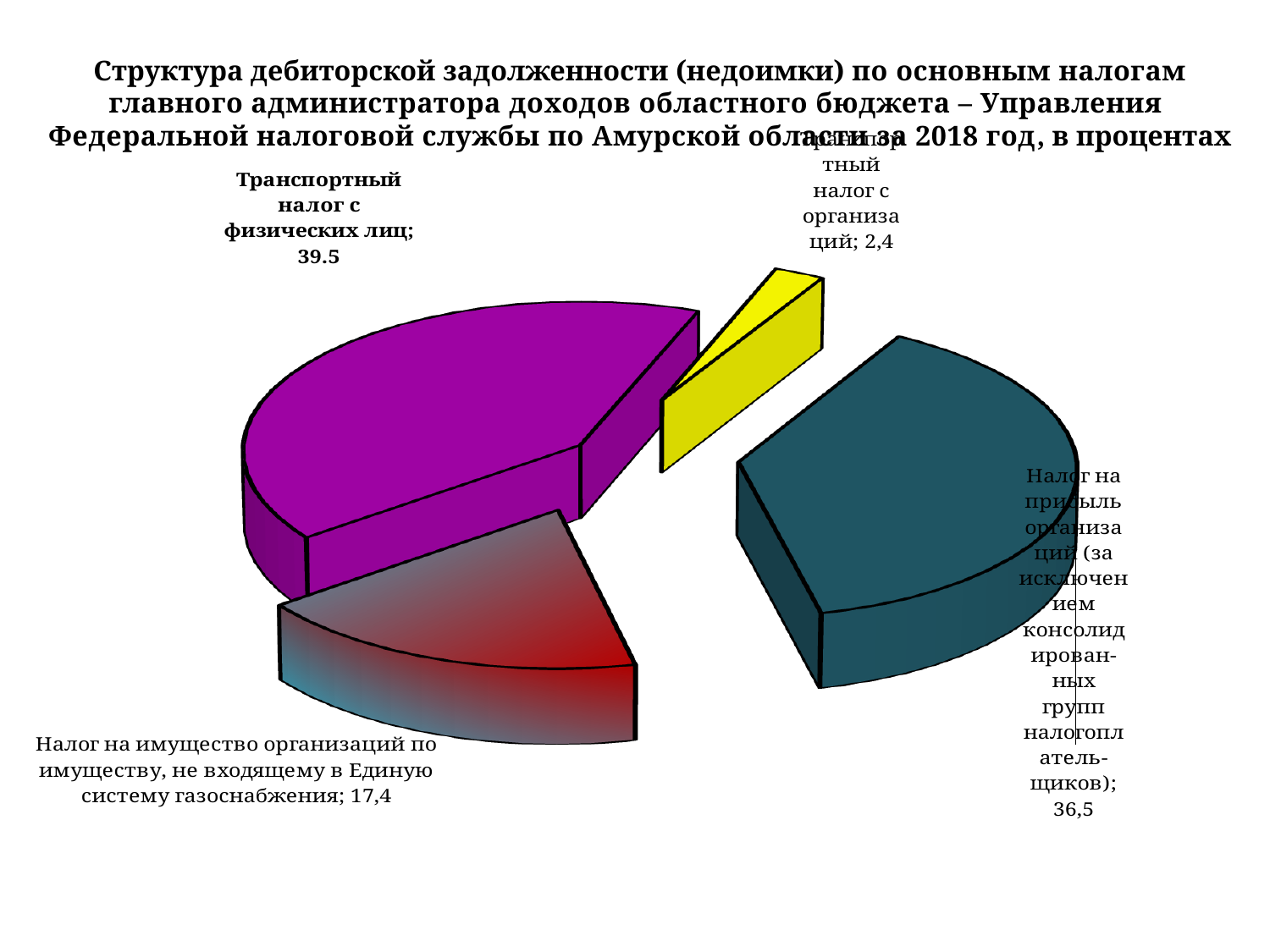
What is the value shown for the slice "Налог на прибыль организаций (за исключением консолидированных групп налогоплательщиков)"? 36,5 What kind of chart is shown on the slide? Pie chart What is the value shown for the slice "Транспортный налог с организаций"? 2,4 What is the value shown for the slice "Налог на имущество организаций по имуществу, не входящему в Единую систему газоснабжения"? 17,4 What is the difference between the values for "Транспортный налог с физических лиц" and "Налог на имущество организаций по имуществу, не входящему в Единую систему газоснабжения"? 22,1 For which year does the chart title say the data is shown? 2018 Which slice of the pie chart has the largest value? Транспортный налог с физических лиц How many slices does the pie chart have? 4 What is the difference between the values for "Налог на прибыль организаций" and "Транспортный налог с организаций"? 34,1 What is the value shown for the slice "Транспортный налог с физических лиц"? 39.5 Which slice of the pie chart has the smallest value? Транспортный налог с организаций Which is larger: the value for "Налог на прибыль организаций" or the value for "Налог на имущество организаций"? Налог на прибыль организаций